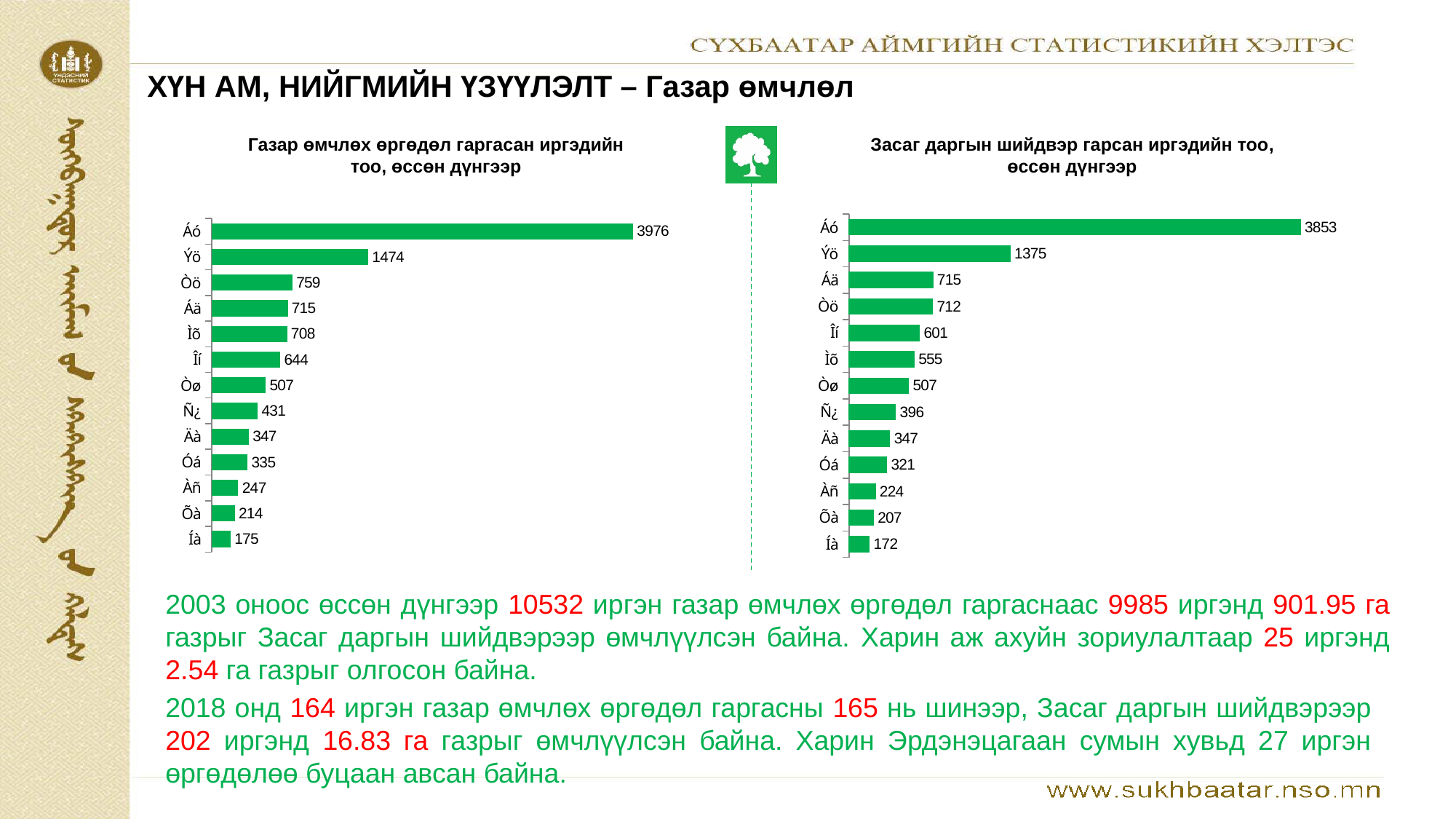
How many categories are shown in the left chart? 13 In the left chart, what is the difference between the values for Áó and Ýö? 2502 In the left chart (Газар өмчлөх өргөдөл гаргасан иргэдийн тоо, өссөн дүнгээр), what is the value for the top category Áó? 3976 In the right chart (Засаг даргын шийдвэр гарсан иргэдийн тоо, өссөн дүнгээр), what is the value for Ýö? 1375 In the left chart, which category has the lowest value? Íà Which is larger: the value for Òö in the left chart or the value for Òö in the right chart? Left chart (759) In the right chart, what is the value for the bottom category Íà? 172 In the right chart, which category has the highest value? Áó What is the title of the left chart? Газар өмчлөх өргөдөл гаргасан иргэдийн тоо, өссөн дүнгээр What type of chart is the right chart? Bar chart How many categories are shown in the right chart? 13 In the right chart, what is the difference between the values for Áä and Òö? 3